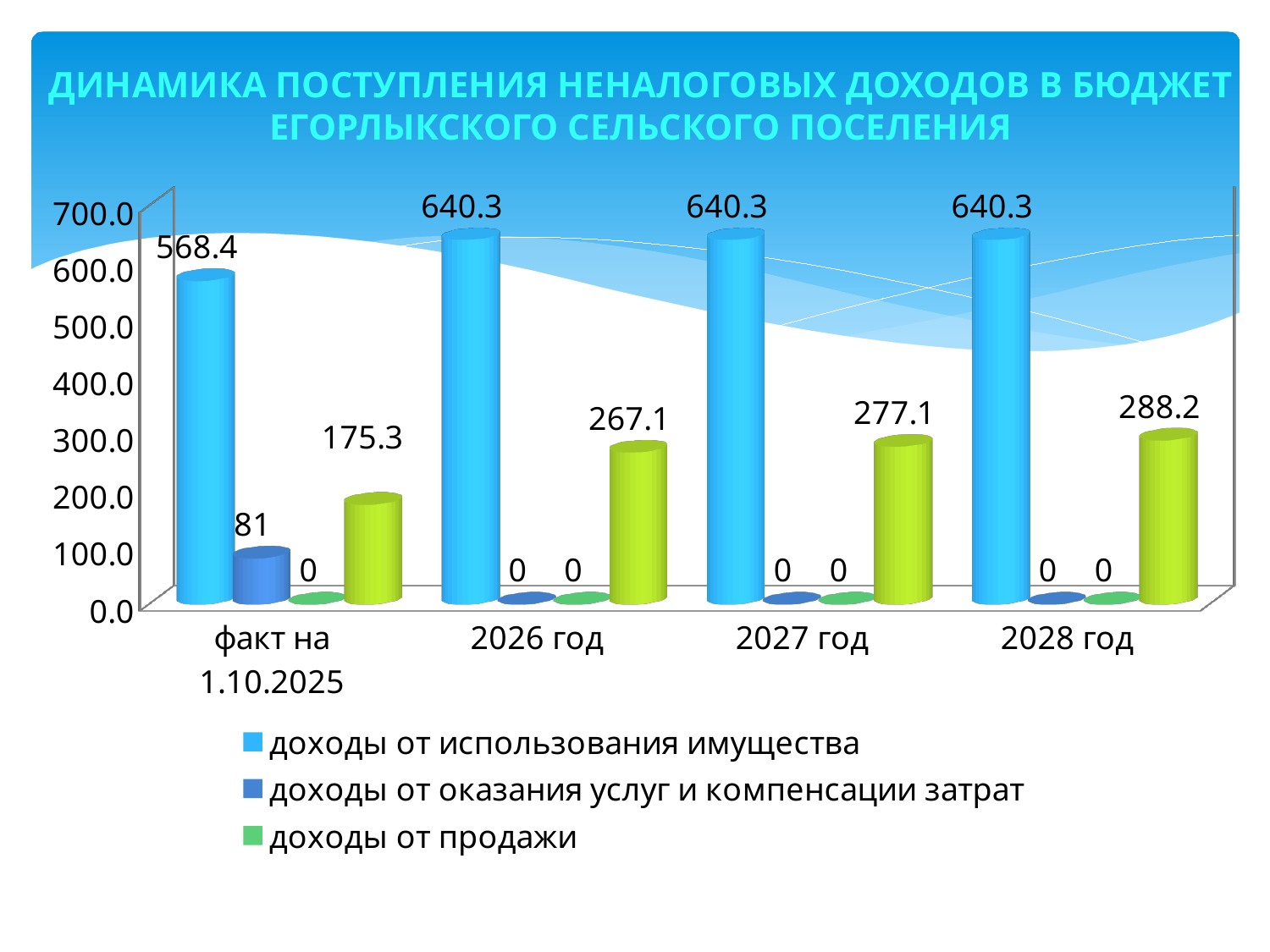
How many series does the legend list? 3 Does the value of доходы от использования имущества rise or fall from факт на 1.10.2025 to 2026 год? rise Which category has the lowest value for доходы от использования имущества? факт на 1.10.2025 What is the value of доходы от использования имущества for 2027 год? 640.3 Which is larger for доходы от использования имущества: факт на 1.10.2025 or 2026 год? 2026 год What is the difference between доходы от использования имущества in 2026 год and in факт на 1.10.2025? 71.9 What is the value of доходы от продажи for 2026 год? 0 What kind of chart is shown on the slide? bar chart What is the value of доходы от оказания услуг и компенсации затрат for факт на 1.10.2025? 81 How many categories are shown on the x axis? 4 What is the value of доходы от использования имущества for факт на 1.10.2025? 568.4 What is the value of доходы от оказания услуг и компенсации затрат for 2028 год? 0